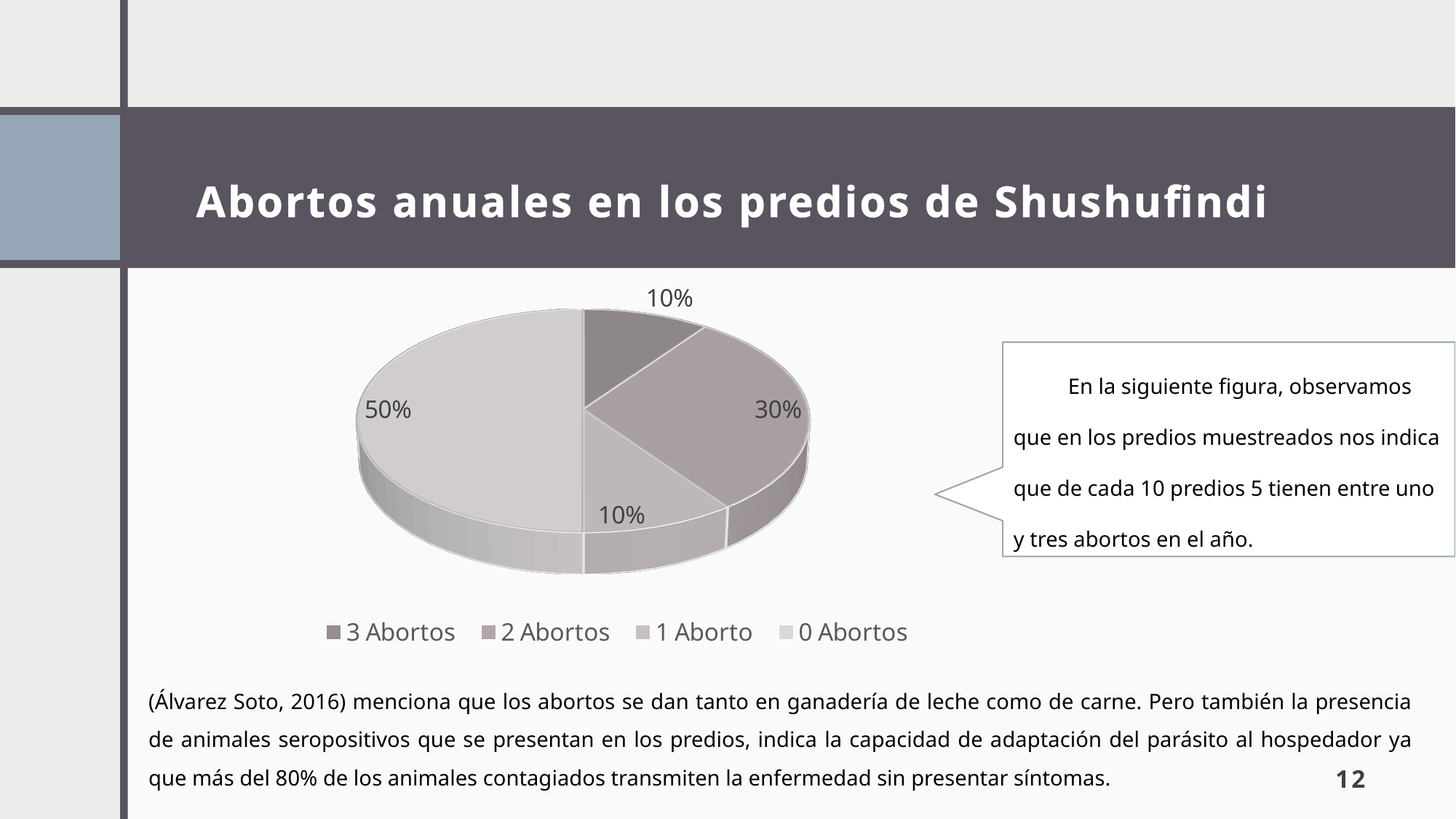
How many slices does the pie chart have? 4 Which category has the largest slice of the pie? 0 Abortos What kind of chart is shown on the slide? Pie chart What share of the pie does the 0 Abortos slice represent? 50% What percentage is shown for 2 Abortos? 30% What is the difference in percentage points between the 0 Abortos slice and the 2 Abortos slice? 20 What percentage of the pie is labelled for 0 Abortos? 50% How many entries does the legend list? 4 Which is larger, the slice for 2 Abortos or the slice for 0 Abortos? 0 Abortos What percentage is shown for 1 Aborto? 10% What is the title of the slide containing the chart? Abortos anuales en los predios de Shushufindi What percentage is shown for 3 Abortos? 10%